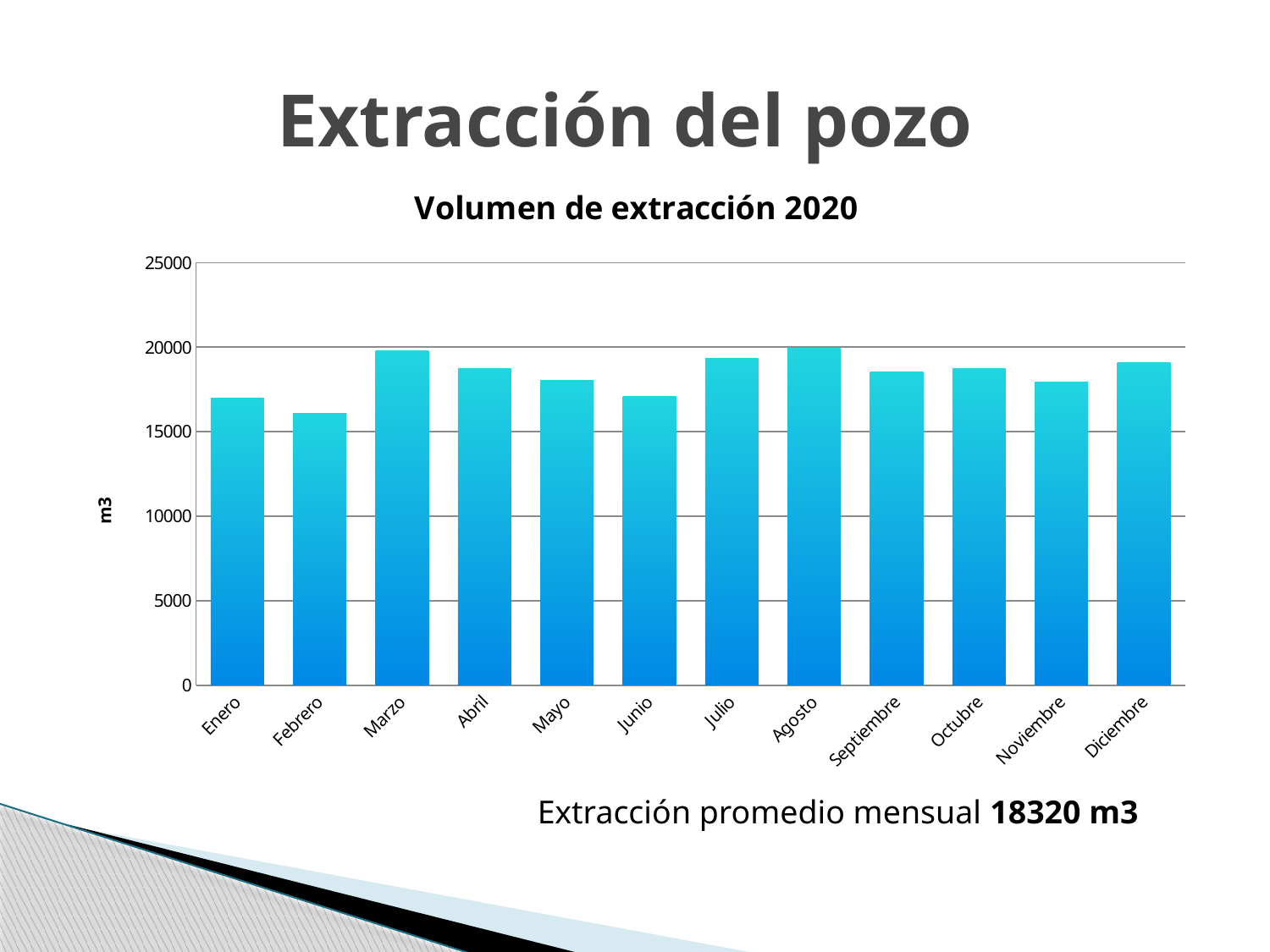
Which is larger, the value for Enero or the value for Febrero? Enero How many months (categories) are plotted on the x axis? 12 Which is larger, the value for Marzo or the value for Febrero? Marzo Which month has the lowest extraction volume? Febrero Which is larger, the value for Julio or the value for Junio? Julio Is the value for Junio greater or less than 20000? less Is the value for Marzo greater or less than 15000? greater Is the value for Febrero greater or less than 20000? less What kind of chart is shown on the slide? bar chart What unit is shown on the vertical axis label of the chart? m3 What is the title of the chart? Volumen de extracción 2020